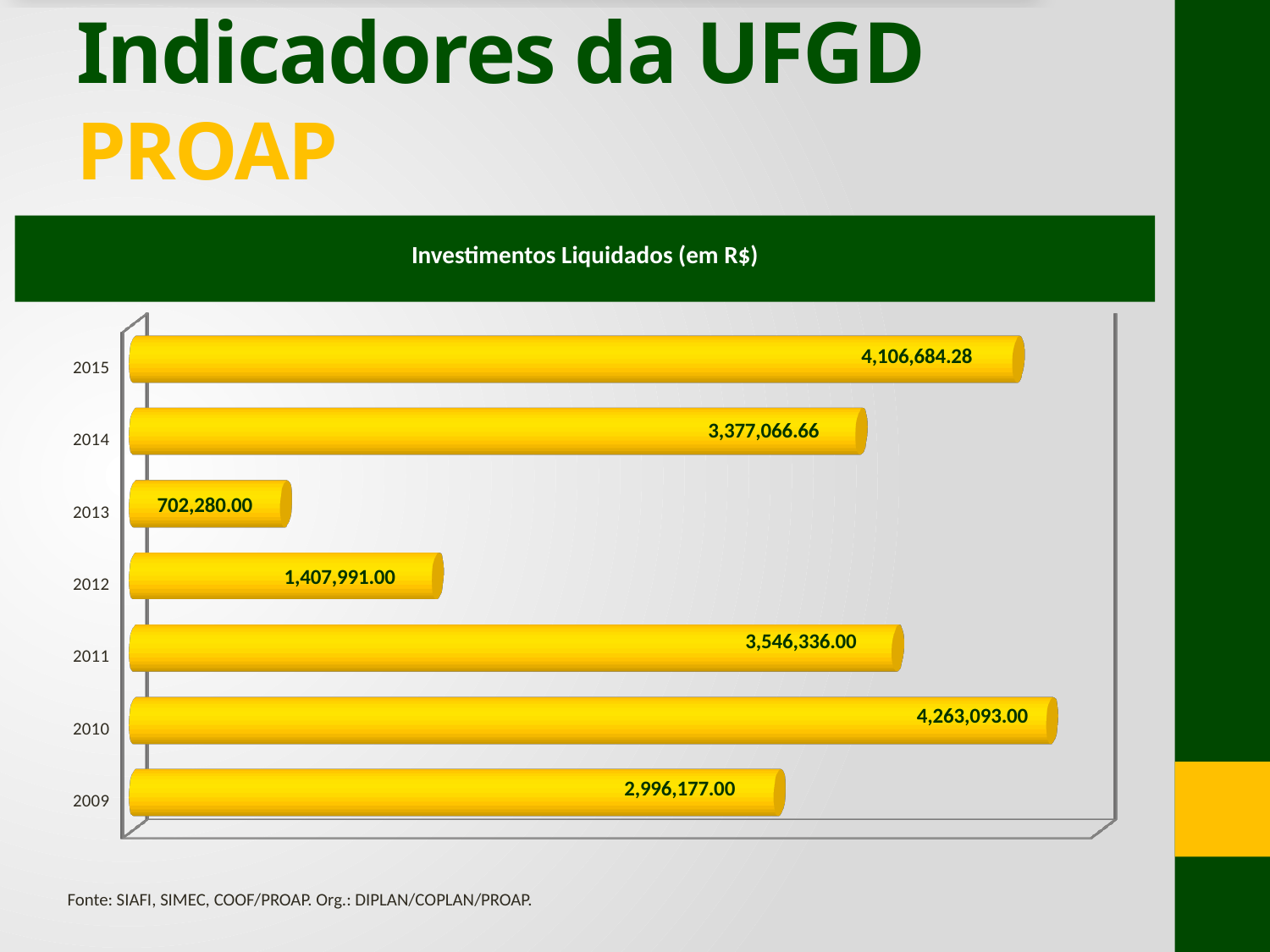
What is the value for 2015 in the Investimentos Liquidados chart? 4,106,684.28 What is the difference between the values for 2015 and 2014 in the Investimentos Liquidados chart? 729,617.62 What kind of chart is used to show Investimentos Liquidados? Bar chart Which year has the lowest value in the Investimentos Liquidados chart? 2013 Which year has the larger value in the Investimentos Liquidados chart, 2011 or 2014? 2011 What is the title of the chart on the slide? Investimentos Liquidados (em R$) What is the value for 2009 in the Investimentos Liquidados chart? 2,996,177.00 Which year has the highest value in the Investimentos Liquidados chart? 2010 Did the value rise or fall from 2013 to 2014 in the Investimentos Liquidados chart? Rise What is the difference between the values for 2010 and 2009 in the Investimentos Liquidados chart? 1,266,916.00 How many years are shown in the Investimentos Liquidados chart? 7 What is the value for 2013 in the Investimentos Liquidados chart? 702,280.00